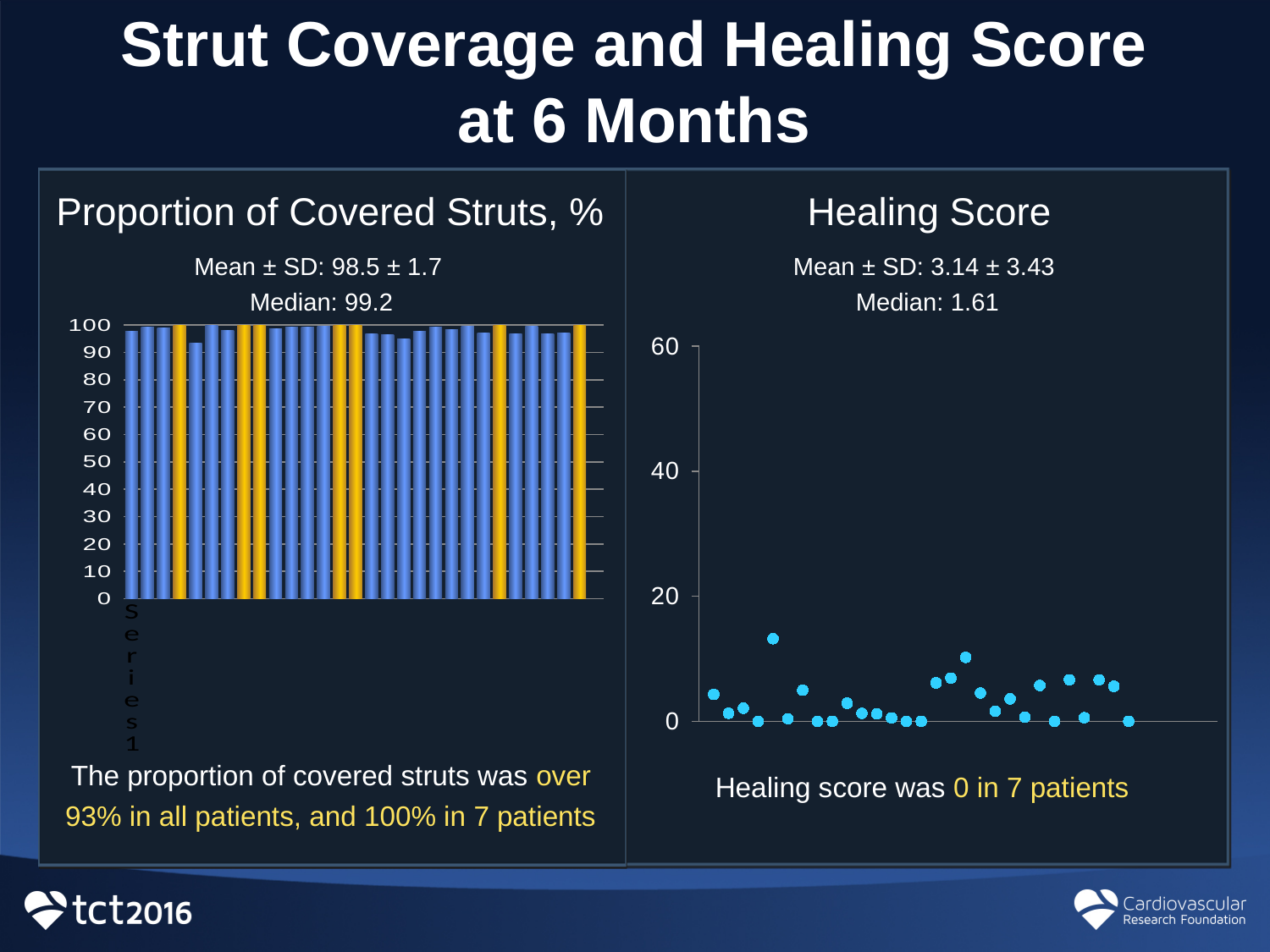
What is the title of the chart on the left side of the slide? Proportion of Covered Struts, % What kind of chart is the 'Healing Score' chart on the right? scatter chart In the 'Proportion of Covered Struts, %' chart, is the shortest bar greater or less than 90? greater What is the highest value shown on the y axis of the 'Healing Score' chart? 60 In the 'Healing Score' chart, are all points greater or less than 40? less In the 'Healing Score' chart, is the highest point greater or less than 10? greater What kind of chart is the 'Proportion of Covered Struts, %' chart on the left? bar chart